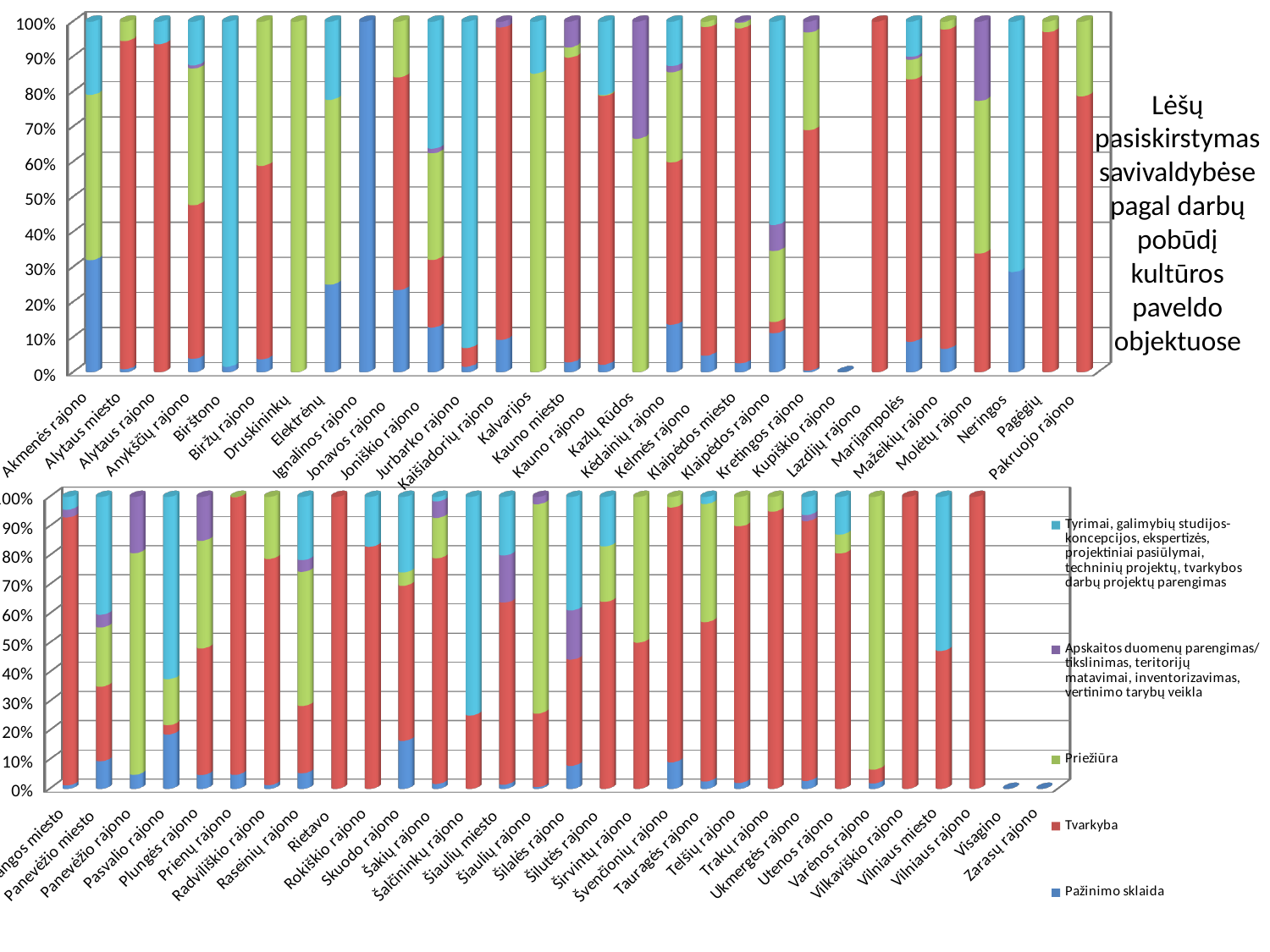
In the top chart, is the Pažinimo sklaida share for Ignalinos rajono greater or less than 90%? greater How many municipalities (categories) are shown in the top chart? 30 What is the title shown on the slide for the charts? Lėšų pasiskirstymas savivaldybėse pagal darbų pobūdį kultūros paveldo objektuose In the top chart, is the Pažinimo sklaida share for Neringos greater or less than 40%? less In the bottom chart, is the Tvarkyba share for Rietavo greater or less than 90%? greater Which legend entry is shown in red? Tvarkyba How many series does the legend list? 5 What kind of chart is the top chart on the slide? Stacked bar chart